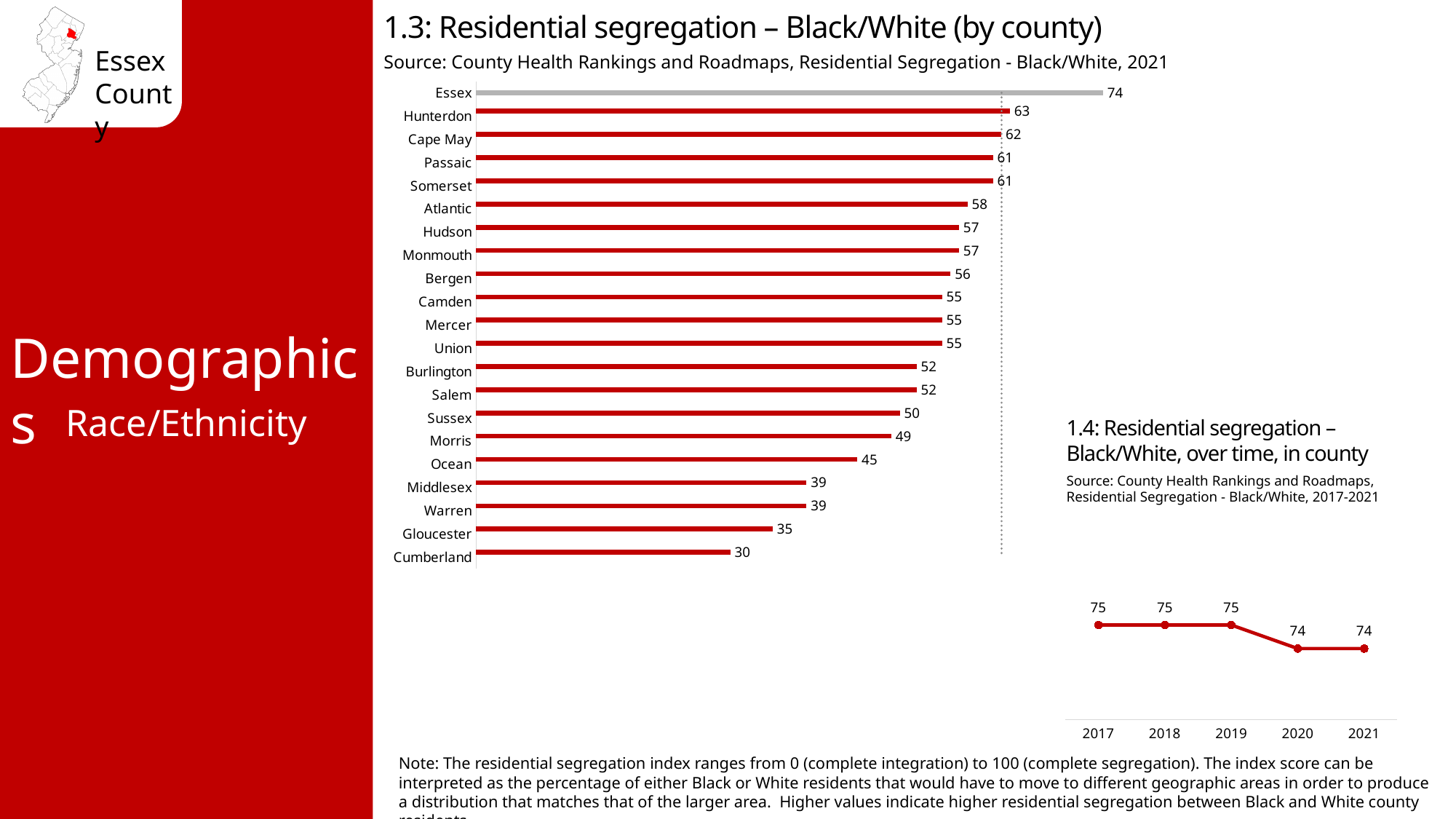
In the chart '1.3: Residential segregation – Black/White (by county)', which county has the lowest value? Cumberland In the chart '1.3: Residential segregation – Black/White (by county)', how many counties are shown? 21 In the chart '1.3: Residential segregation – Black/White (by county)', which county has the highest value? Essex In the chart '1.4: Residential segregation – Black/White, over time, in county', do the values rise or fall from 2017 to 2021? Fall What kind of chart is '1.3: Residential segregation – Black/White (by county)'? Bar chart In the chart '1.3: Residential segregation – Black/White (by county)', which has a larger value, Ocean or Morris? Ocean In the chart '1.3: Residential segregation – Black/White (by county)', what is the value for Cumberland? 30 In the chart '1.3: Residential segregation – Black/White (by county)', what is the value for Essex? 74 In the chart '1.4: Residential segregation – Black/White, over time, in county', what is the value for 2021? 74 In the chart '1.4: Residential segregation – Black/White, over time, in county', what is the value for 2017? 75 In the chart '1.3: Residential segregation – Black/White (by county)', what is the difference between the values for Essex and Hunterdon? 11 What kind of chart is '1.4: Residential segregation – Black/White, over time, in county'? Line chart